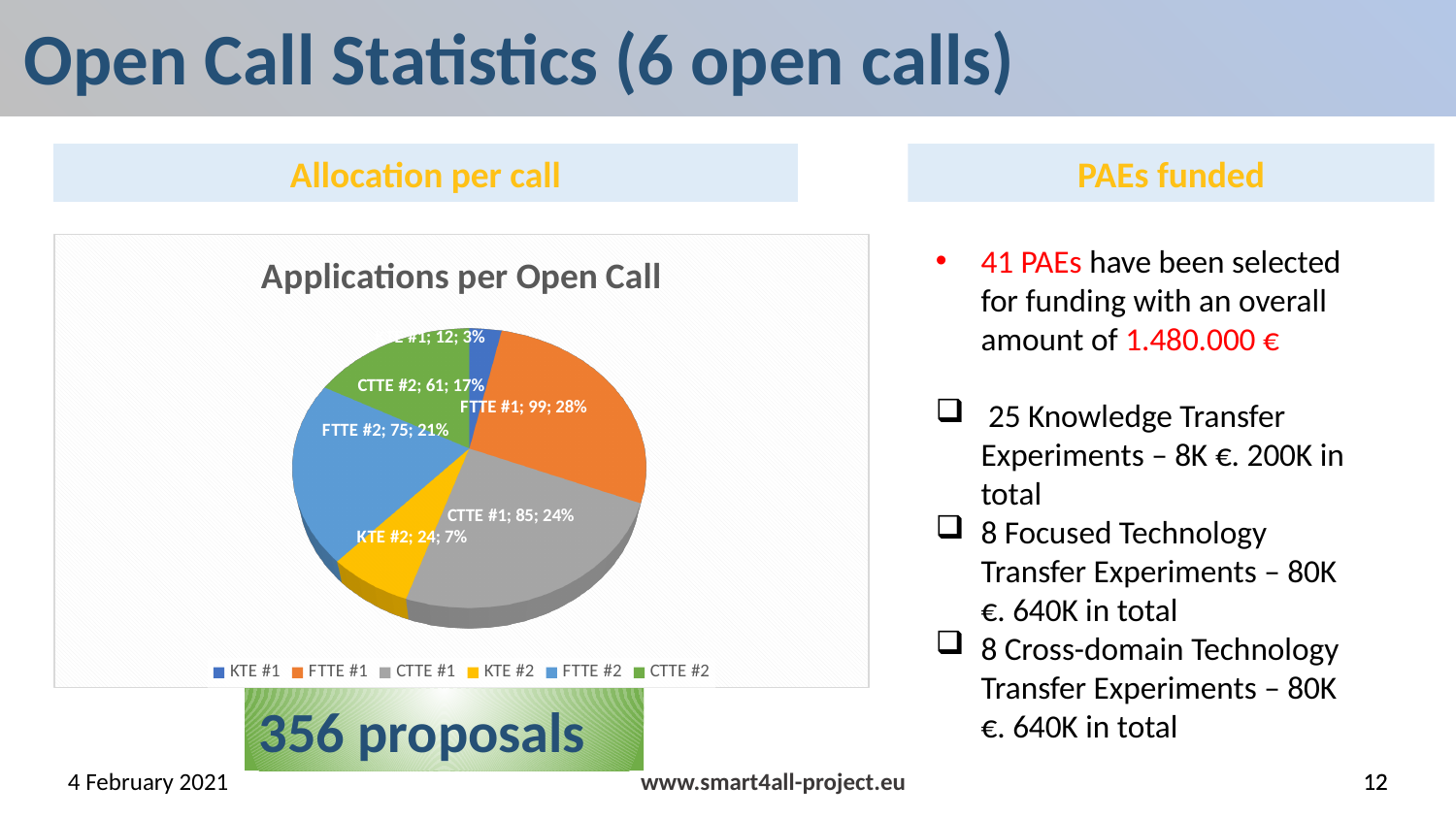
Which legend entry is shown in orange? FTTE #1 Which received more applications, CTTE #1 or CTTE #2? CTTE #1 What is the difference in applications between FTTE #2 and KTE #2? 51 Which open call received the most applications? FTTE #1 How many applications were received for CTTE #2? 61 What is the title of the chart? Applications per Open Call Which open call received the fewest applications? KTE #1 What share of the pie does CTTE #1 represent? 24% What type of chart is shown on the slide? pie chart What share of the pie does KTE #2 represent? 7% How many applications were received for FTTE #1? 99 How many categories does the pie chart show? 6